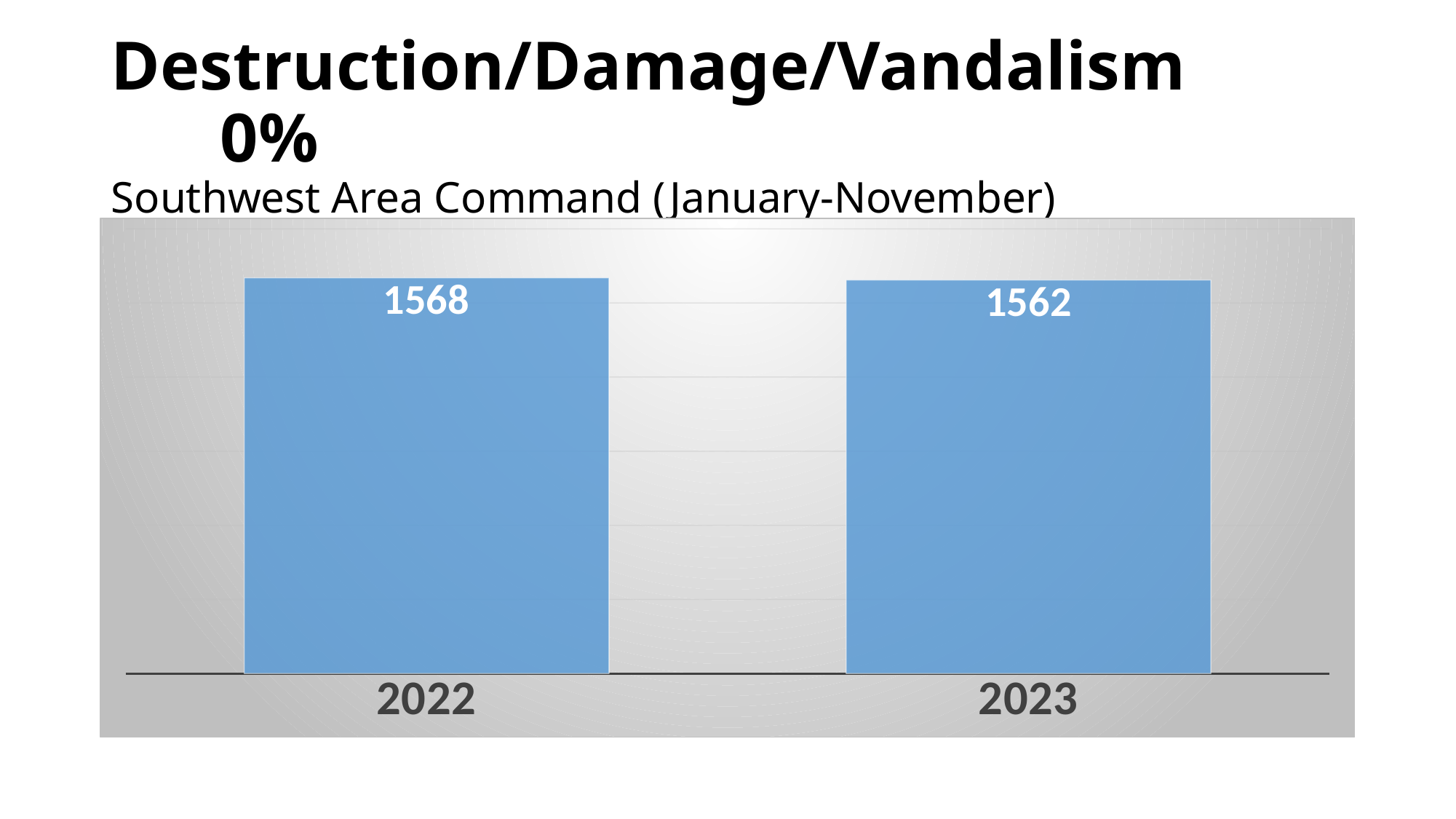
What is the title of the chart? Destruction/Damage/Vandalism 0% Which year has the higher value? 2022 What is the value for 2023? 1562 Do the values rise or fall from 2022 to 2023? fall What is the difference between the 2022 and 2023 values? 6 Is the value for 2022 larger or smaller than the value for 2023? larger How many categories are shown on the x axis? 2 What is the value for 2022? 1568 Which area command and period does the chart cover, according to the subtitle? Southwest Area Command (January-November) Which year has the lower value? 2023 What kind of chart is shown on the slide? bar chart